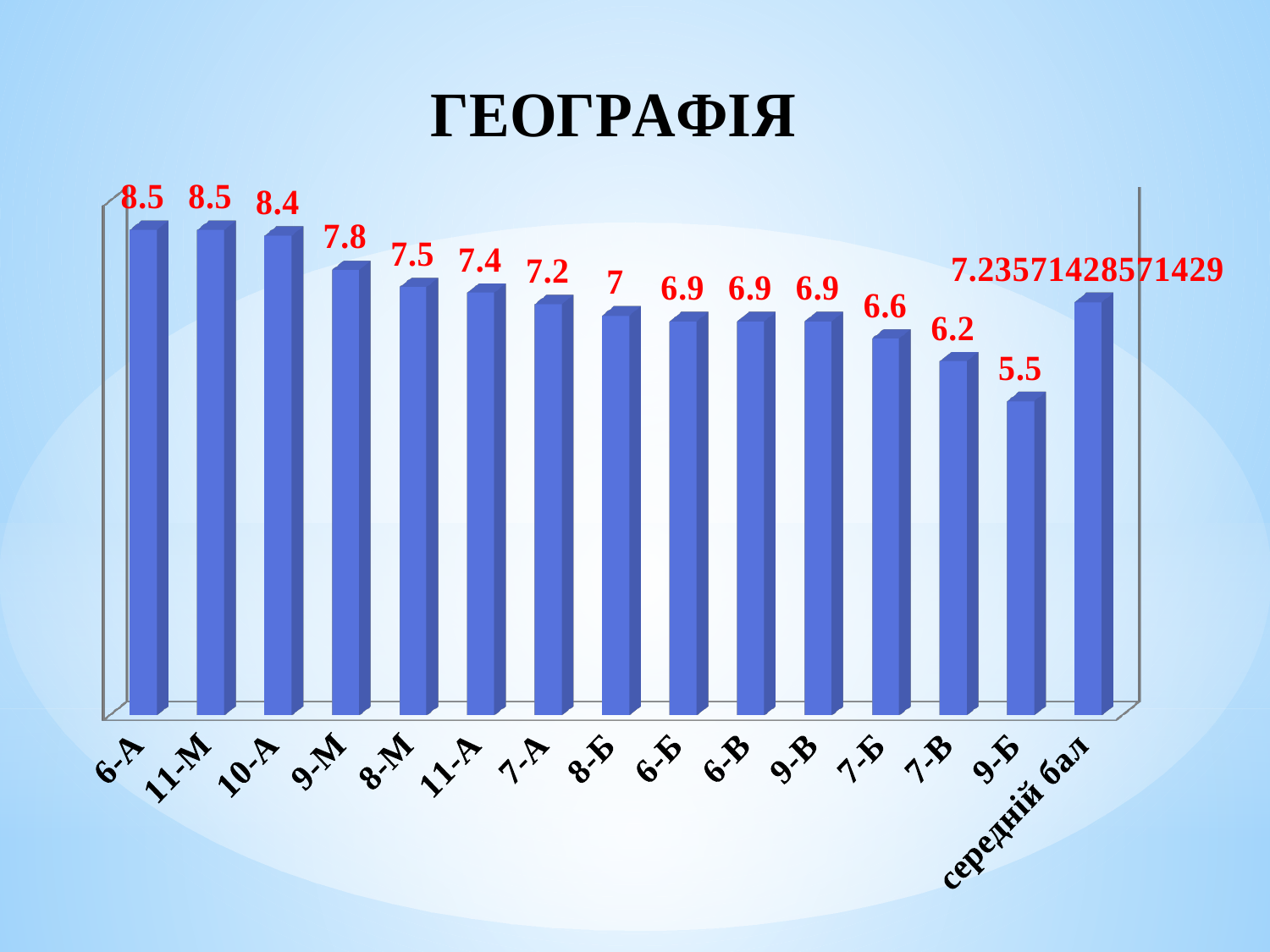
How many categories are shown on the x axis? 15 What is the value for 8-Б? 7 What is the value for 7-В? 6.2 What kind of chart is this? bar chart What is the value for 9-М? 7.8 Which is larger, the value for 9-М or the value for 8-М? 9-М Which category has the lowest value? 9-Б What is the title of the chart? ГЕОГРАФІЯ Which is larger, the value for 7-В or the value for 9-Б? 7-В What is the difference between the values for 10-А and 7-Б? 1.8 What is the value shown for середній бал? 7.23571428571429 What is the difference between the values for 6-А and 9-Б? 3